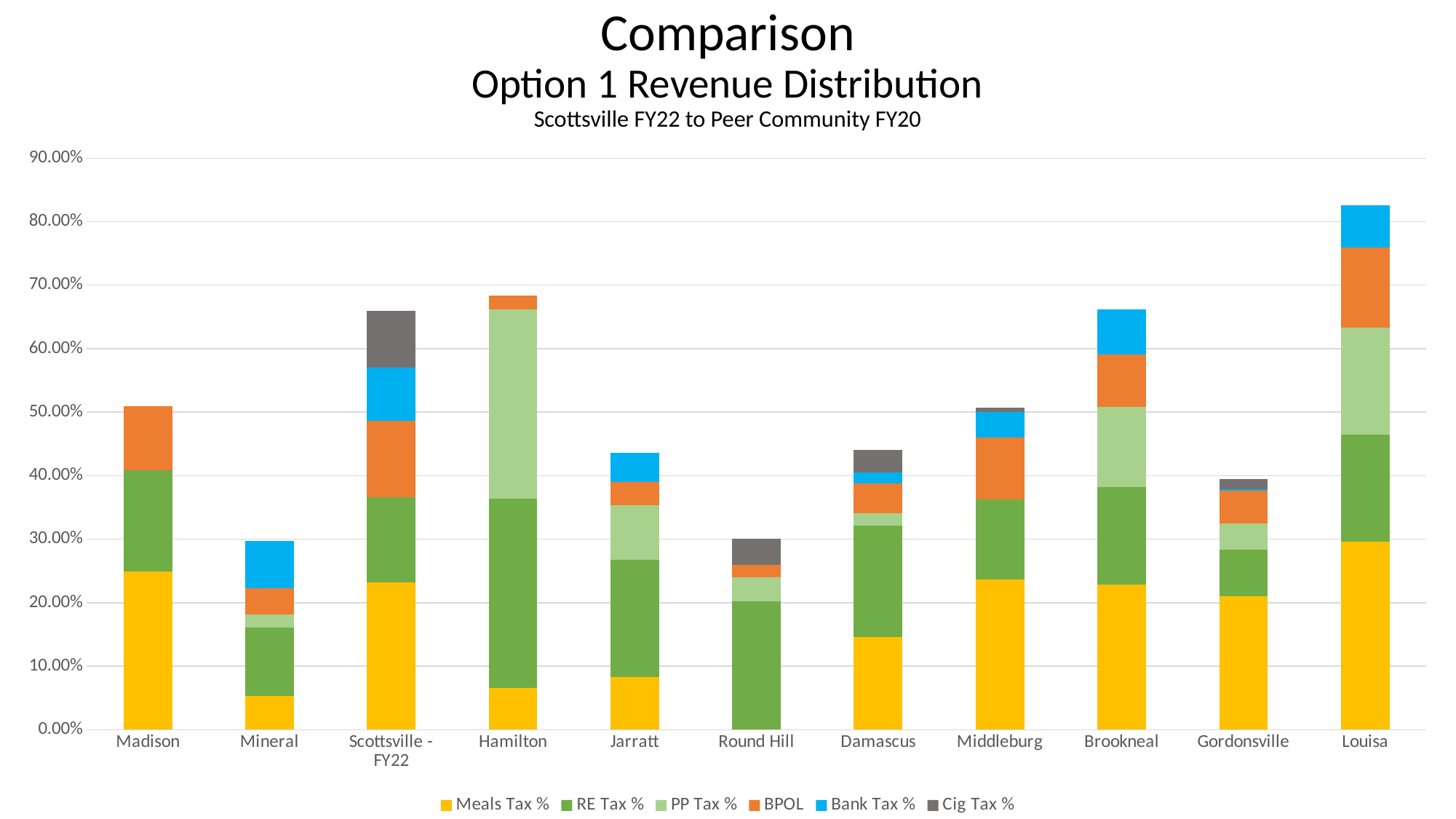
How many communities are shown along the x axis? 11 Is the total for Louisa greater or less than 80.00%? greater Which community has the largest Cig Tax % segment? Scottsville - FY22 What kind of chart is shown on the slide? Stacked bar chart Is the total for Scottsville - FY22 greater or less than 60.00%? greater Which has the larger total bar, Hamilton or Jarratt? Hamilton Which community has the highest total stacked bar? Louisa Is the total for Damascus greater or less than 50.00%? less How many series does the legend list? 6 What is the subtitle shown below 'Option 1 Revenue Distribution'? Scottsville FY22 to Peer Community FY20 Which community has the largest PP Tax % segment? Hamilton